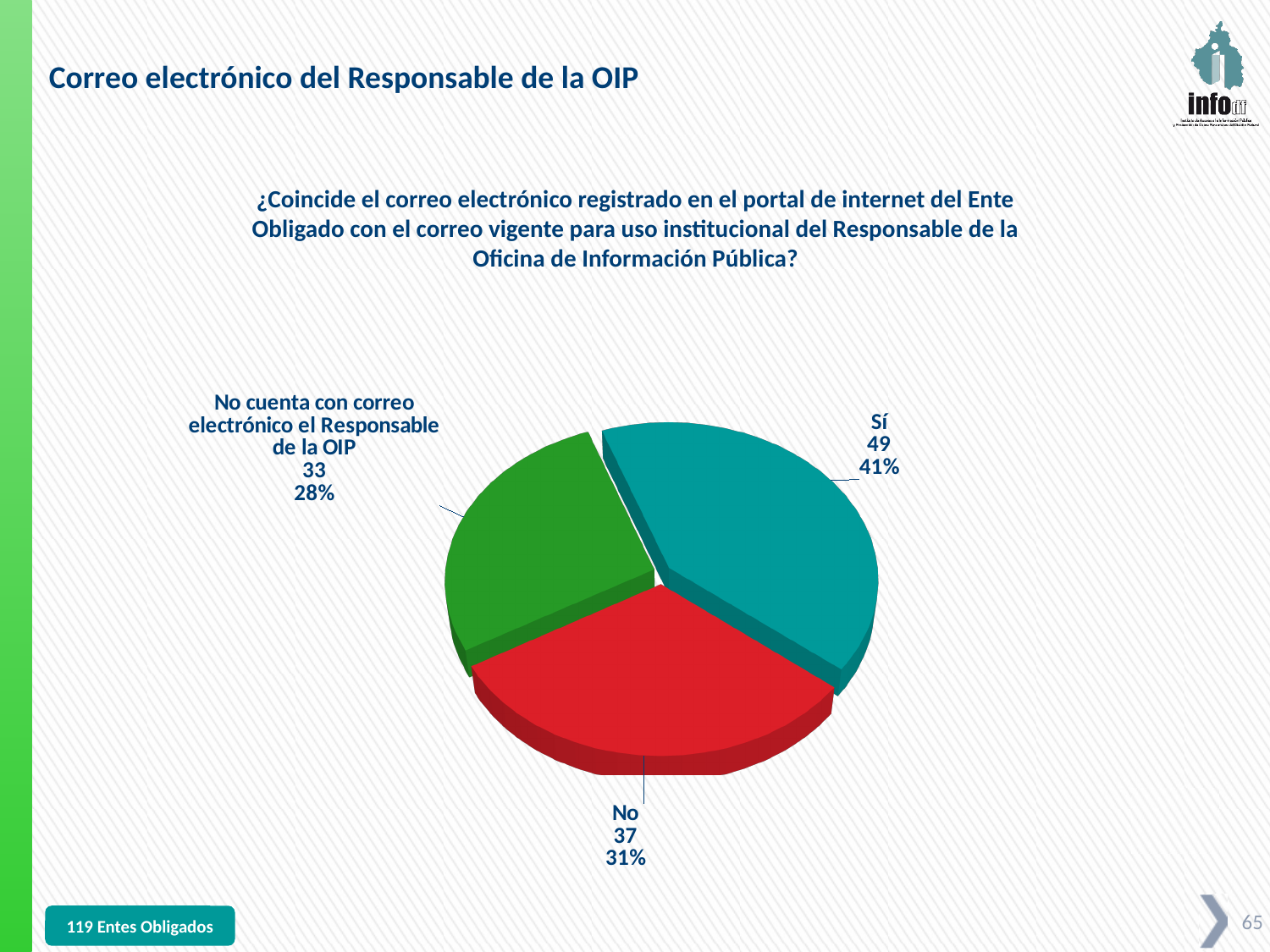
What percentage share does the "Sí" slice represent? 41% What percentage share does the "No cuenta con correo electrónico el Responsable de la OIP" slice represent? 28% Which slice has the largest value? Sí How many slices does the pie chart have? 3 What is the count for the "No cuenta con correo electrónico el Responsable de la OIP" slice? 33 Which slice is larger, "No" or "No cuenta con correo electrónico el Responsable de la OIP"? No What kind of chart is shown on the slide? pie chart Which slice has the smallest value? No cuenta con correo electrónico el Responsable de la OIP What is the count for the "Sí" slice? 49 What is the difference between the "Sí" count and the "No" count? 12 What is the count for the "No" slice? 37 What percentage share does the "No" slice represent? 31%